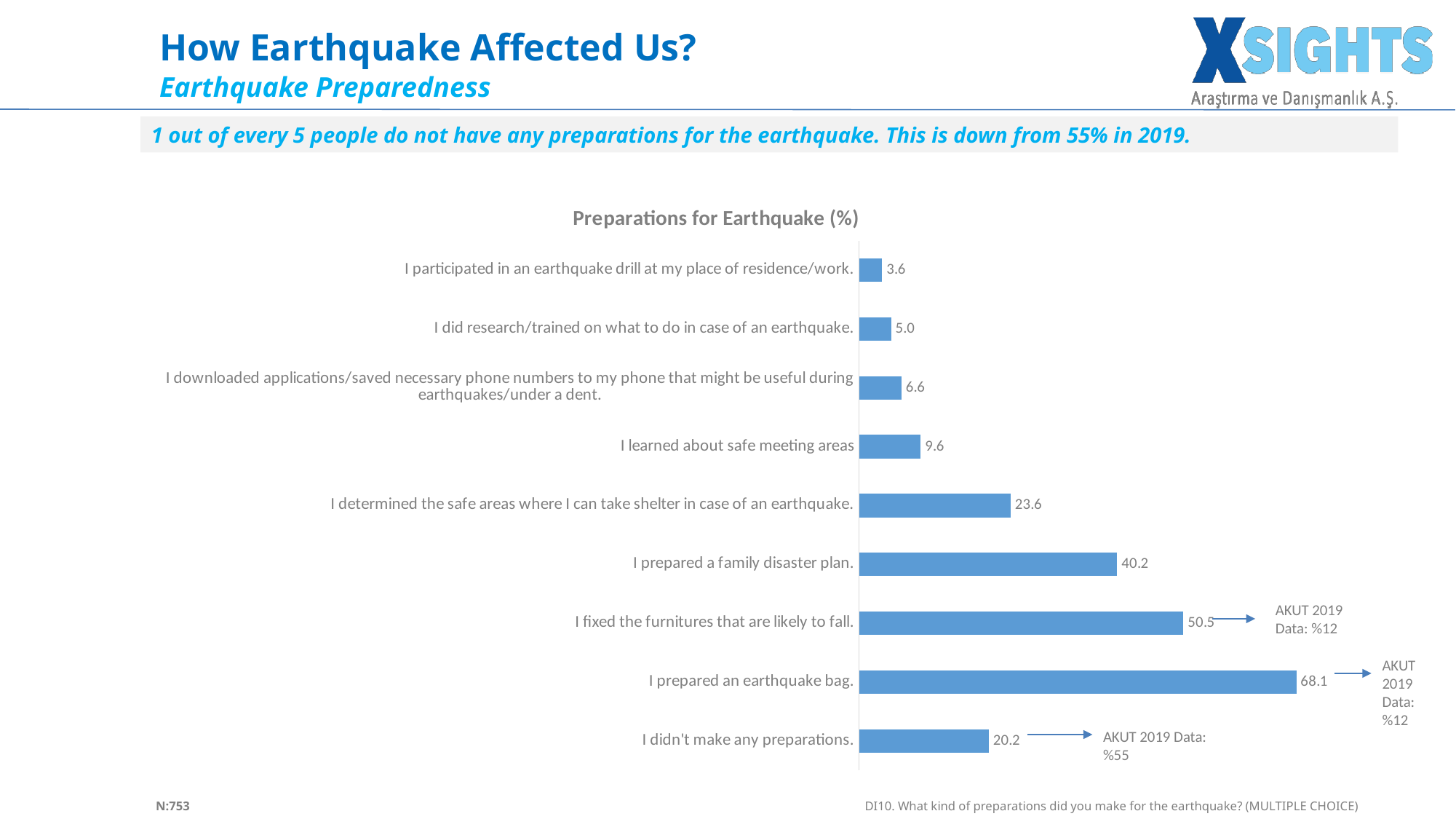
What is the difference between the values for "I prepared an earthquake bag." and "I fixed the furnitures that are likely to fall."? 17.6 What is the value for "I didn't make any preparations."? 20.2 What is the value for "I learned about safe meeting areas"? 9.6 Which is larger: the value for "I determined the safe areas where I can take shelter in case of an earthquake." or "I didn't make any preparations."? I determined the safe areas where I can take shelter in case of an earthquake. What is the title of the chart? Preparations for Earthquake (%) What is the value for "I prepared a family disaster plan."? 40.2 Which category has the lowest value? I participated in an earthquake drill at my place of residence/work. What kind of chart is shown on the slide? Bar chart Which category has the highest value? I prepared an earthquake bag. What is the value for "I prepared an earthquake bag."? 68.1 How many categories are shown in the chart? 9 What AKUT 2019 data value is annotated next to "I didn't make any preparations."? %55